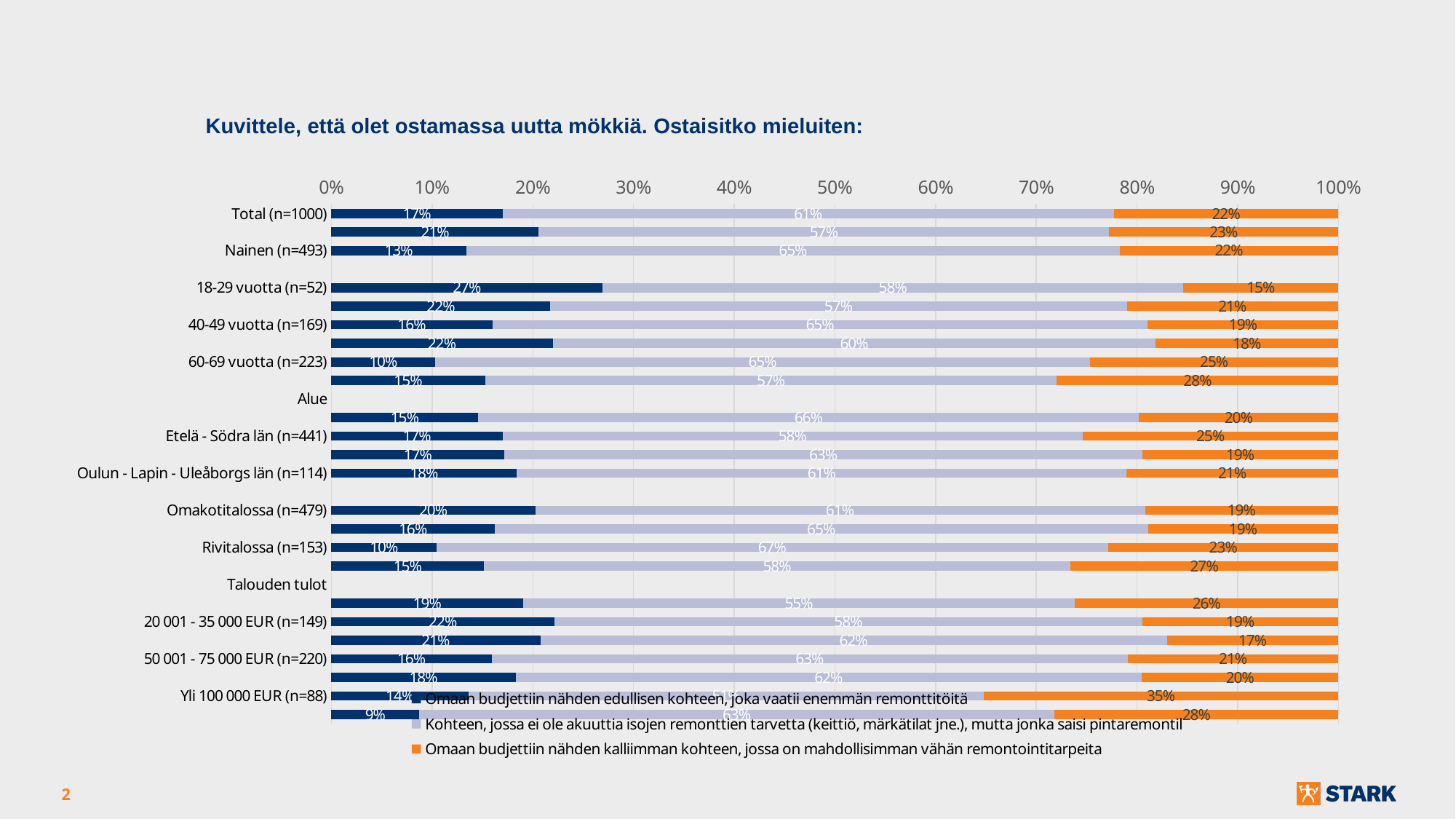
What is the value of the dark blue series (Omaan budjettiin nähden edullisen kohteen) for Total (n=1000)? 17% How many series does the legend list? 3 What is the difference between the dark blue values for 18-29 vuotta (n=52) and 60-69 vuotta (n=223)? 17 percentage points Which category has the highest value for the orange series (Omaan budjettiin nähden kalliimman kohteen)? Yli 100 000 EUR (n=88) What is the value of the light purple series (Kohteen, jossa ei ole akuuttia isojen remonttien tarvetta) for Nainen (n=493)? 65% What is the value of the orange series for Yli 100 000 EUR (n=88)? 35% What kind of chart is shown on the slide? Stacked bar chart Which has a larger light purple value: Rivitalossa (n=153) or Omakotitalossa (n=479)? Rivitalossa (n=153) What is the value of the dark blue series for 18-29 vuotta (n=52)? 27% Which category has the lowest value for the orange series (Omaan budjettiin nähden kalliimman kohteen)? 18-29 vuotta (n=52) What is the value of the orange series (Omaan budjettiin nähden kalliimman kohteen) for 60-69 vuotta (n=223)? 25% What is the title of the chart? Kuvittele, että olet ostamassa uutta mökkiä. Ostaisitko mieluiten: